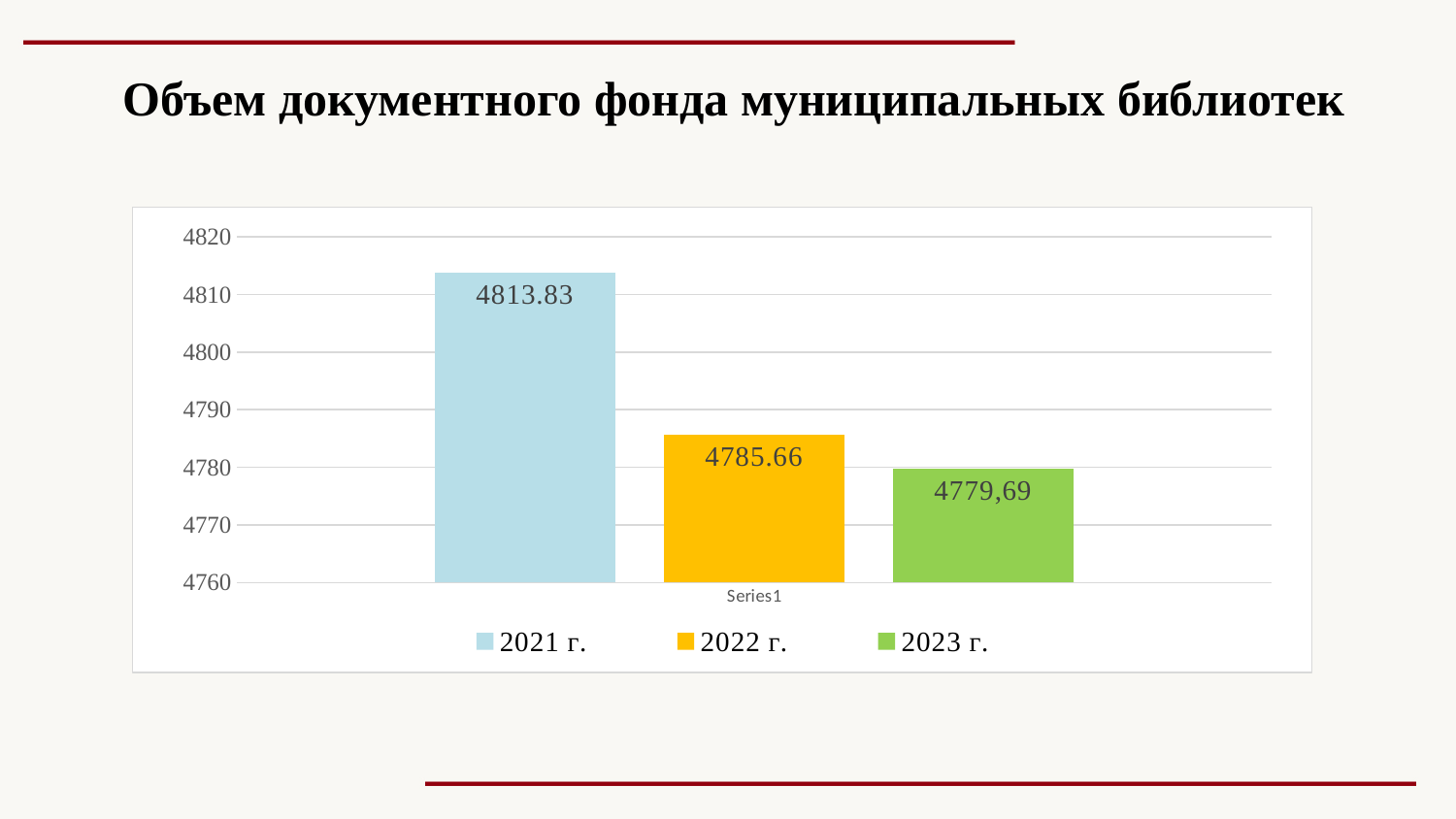
What is the value for 2023 г.? 4779,69 What is the value for 2022 г.? 4785.66 What is the value for 2021 г.? 4813.83 What is the difference between the values for 2021 г. and 2023 г.? 34.14 Which is larger, the value for 2022 г. or the value for 2023 г.? 2022 г. Which year has the highest value? 2021 г. Is the value for 2022 г. greater or less than 4800? less What is the difference between the values for 2021 г. and 2022 г.? 28.17 Which year has the lowest value? 2023 г. What kind of chart is shown on the slide? bar chart How many series does the legend list? 3 How many bars are plotted in the chart? 3